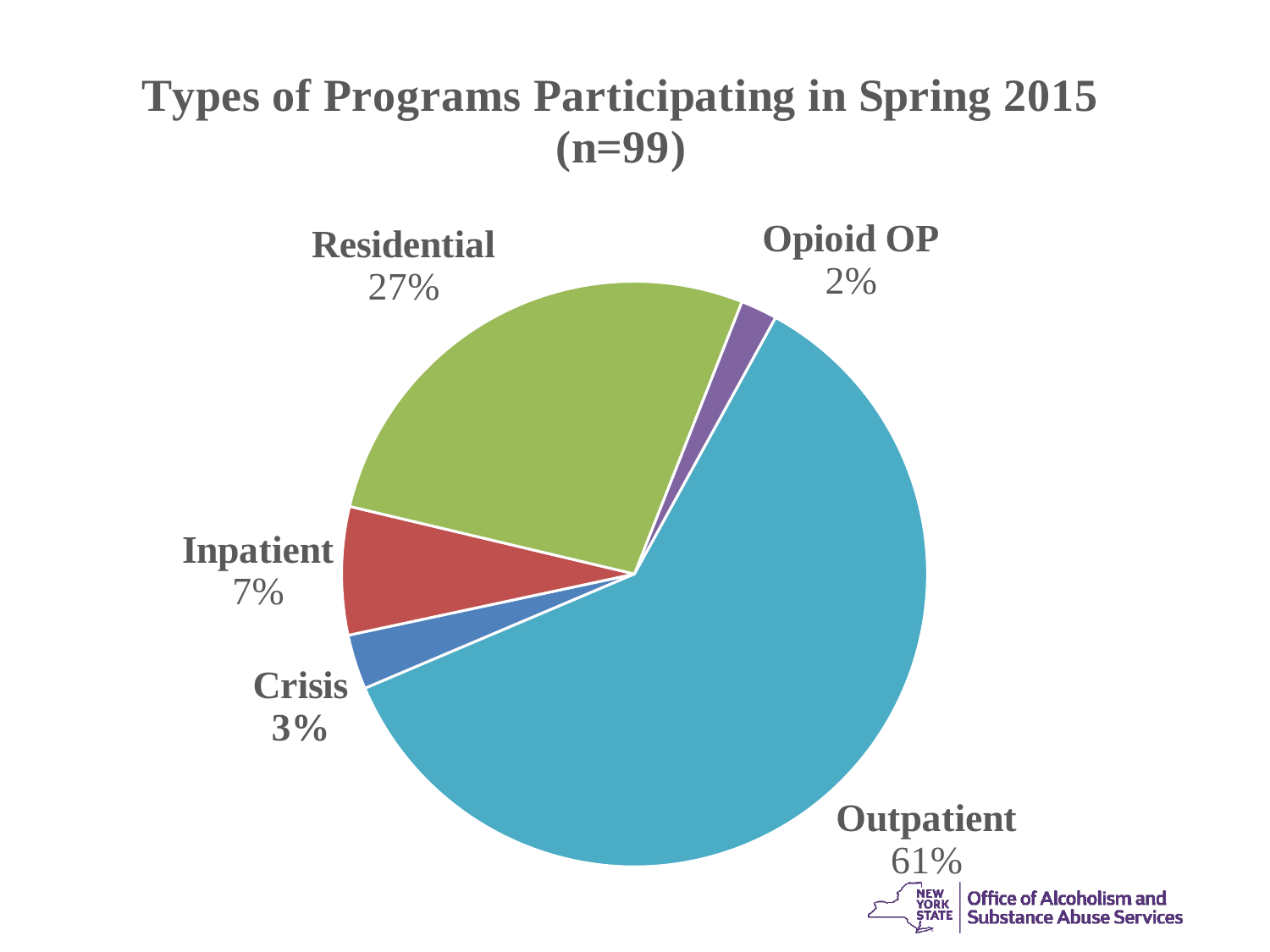
What percentage of programs were Inpatient? 7% What is the sample size (n) given in the chart title? 99 What is the difference in percentage points between Outpatient and Residential? 34 What percentage of programs were Opioid OP? 2% Which program type has the smallest share of the pie? Opioid OP Which program type has the largest share of the pie? Outpatient What percentage of programs were Residential? 27% How many program types are shown in the pie chart? 5 What percentage of programs were Crisis? 3% Which has a larger share, Inpatient or Crisis? Inpatient What share of programs participating in Spring 2015 were Outpatient? 61% What type of chart is shown on the slide? pie chart